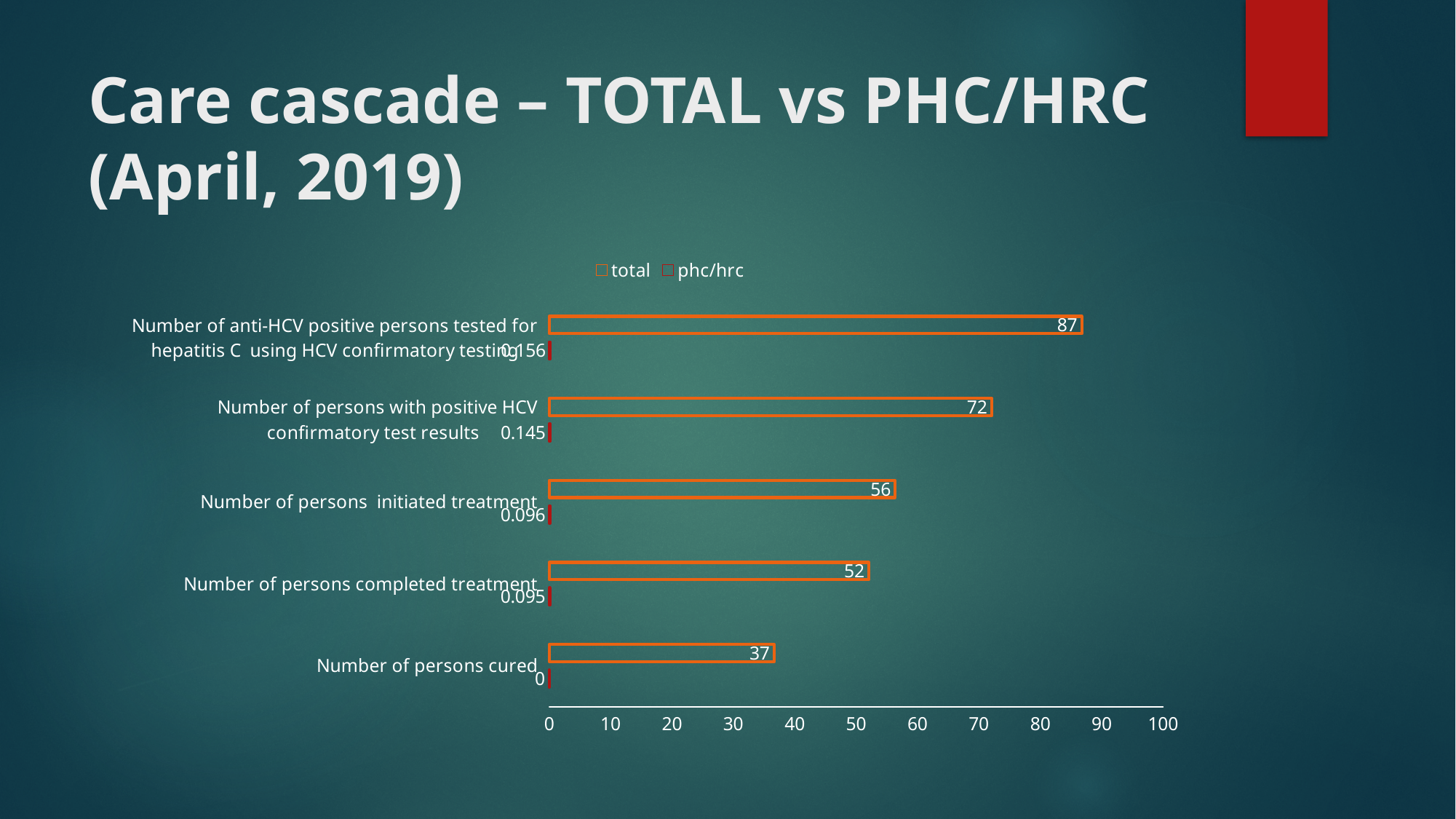
What is the phc/hrc value for Number of persons with positive HCV confirmatory test results? 0.145 What is the difference between the total values for Number of persons initiated treatment and Number of persons completed treatment? 4 How many series does the legend list? 2 What is the total value for Number of persons initiated treatment? 56 What is the total value for Number of persons cured? 37 How many categories are shown on the chart? 5 Which category has the lowest total value? Number of persons cured What are the two series named in the legend? total and phc/hrc Which category has the highest total value? Number of anti-HCV positive persons tested for hepatitis C using HCV confirmatory testing Which is larger: the total value for Number of persons with positive HCV confirmatory test results or for Number of persons completed treatment? Number of persons with positive HCV confirmatory test results What kind of chart is shown on the slide? Bar chart What is the phc/hrc value for Number of persons cured? 0